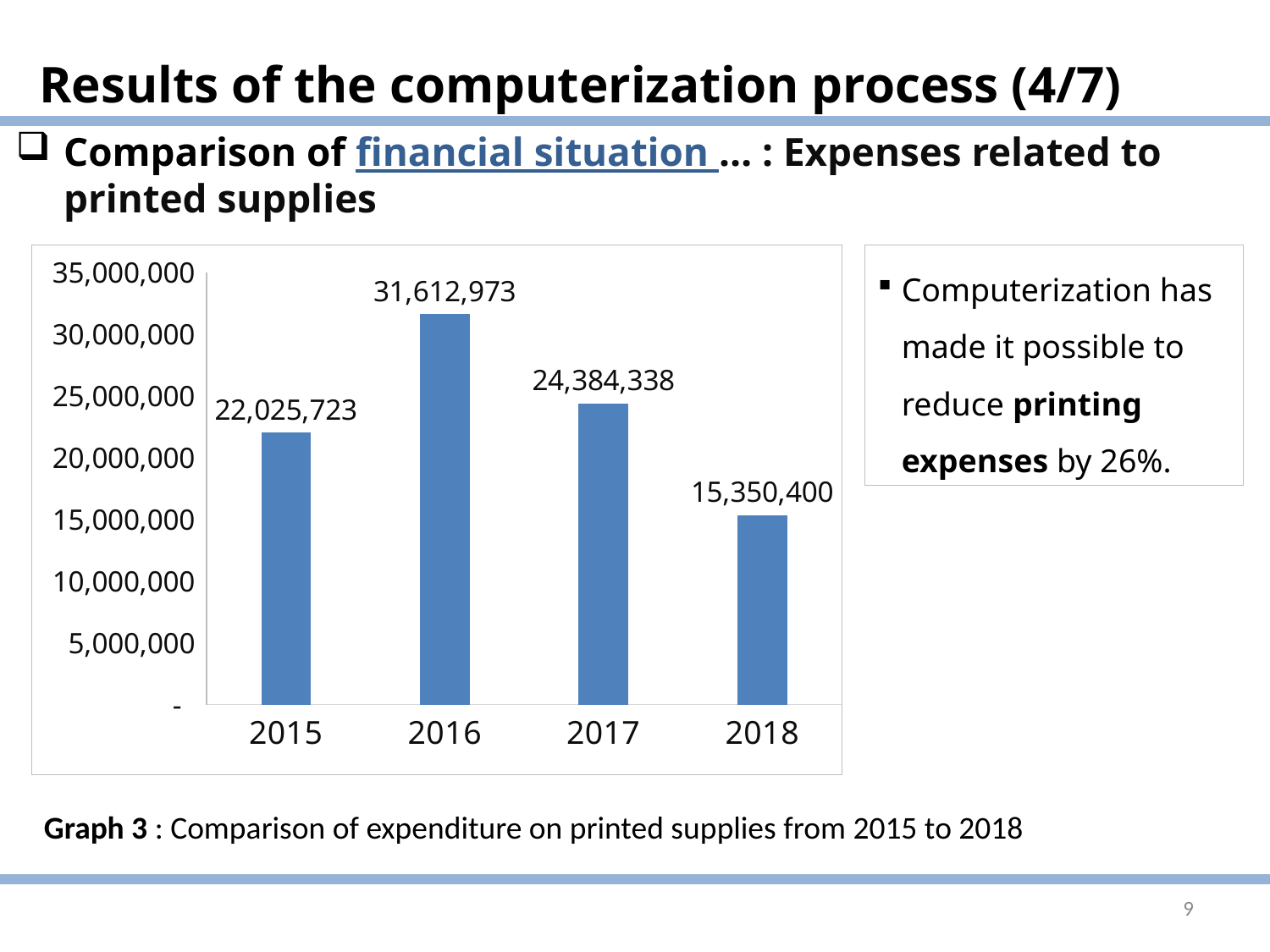
Which year has the lowest expenditure? 2018 What is the difference between the values for 2017 and 2018? 9,033,938 What is the value for 2015? 22,025,723 Which is larger, the value for 2015 or the value for 2017? 2017 What is the difference between the values for 2016 and 2015? 9,587,250 Do the values rise or fall from 2016 to 2018? fall Is the value for 2018 greater or less than 20,000,000? less Which year has the highest expenditure? 2016 How many years are shown on the x axis? 4 What is the value for 2018? 15,350,400 What is the value for 2016? 31,612,973 What kind of chart is shown on the slide? bar chart